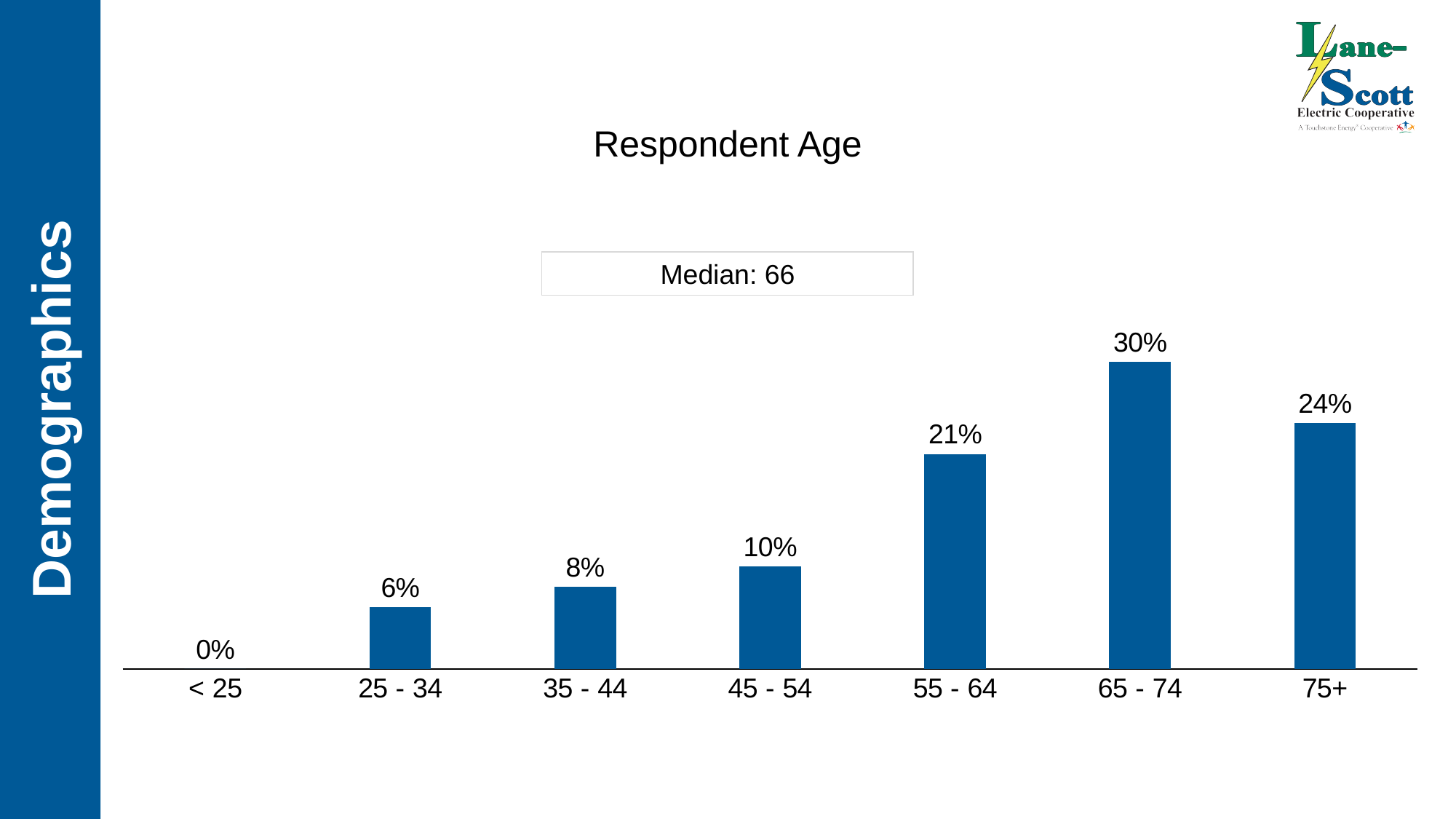
Which age group has the highest share of respondents? 65 - 74 What is the difference in percentage points between the 55 - 64 and 45 - 54 age groups? 11 What percentage of respondents are under 25? 0% What percentage of respondents are aged 25 - 34? 6% Which age group has the lowest share of respondents? < 25 What percentage of respondents are aged 65 - 74? 30% What median age is shown on the chart? 66 What type of chart is used to show respondent age? Bar chart What percentage of respondents are aged 75+? 24% How many age categories are shown on the chart? 7 What is the difference in percentage points between the 65 - 74 and 75+ age groups? 6 Which age group has a larger share of respondents, 35 - 44 or 45 - 54? 45 - 54